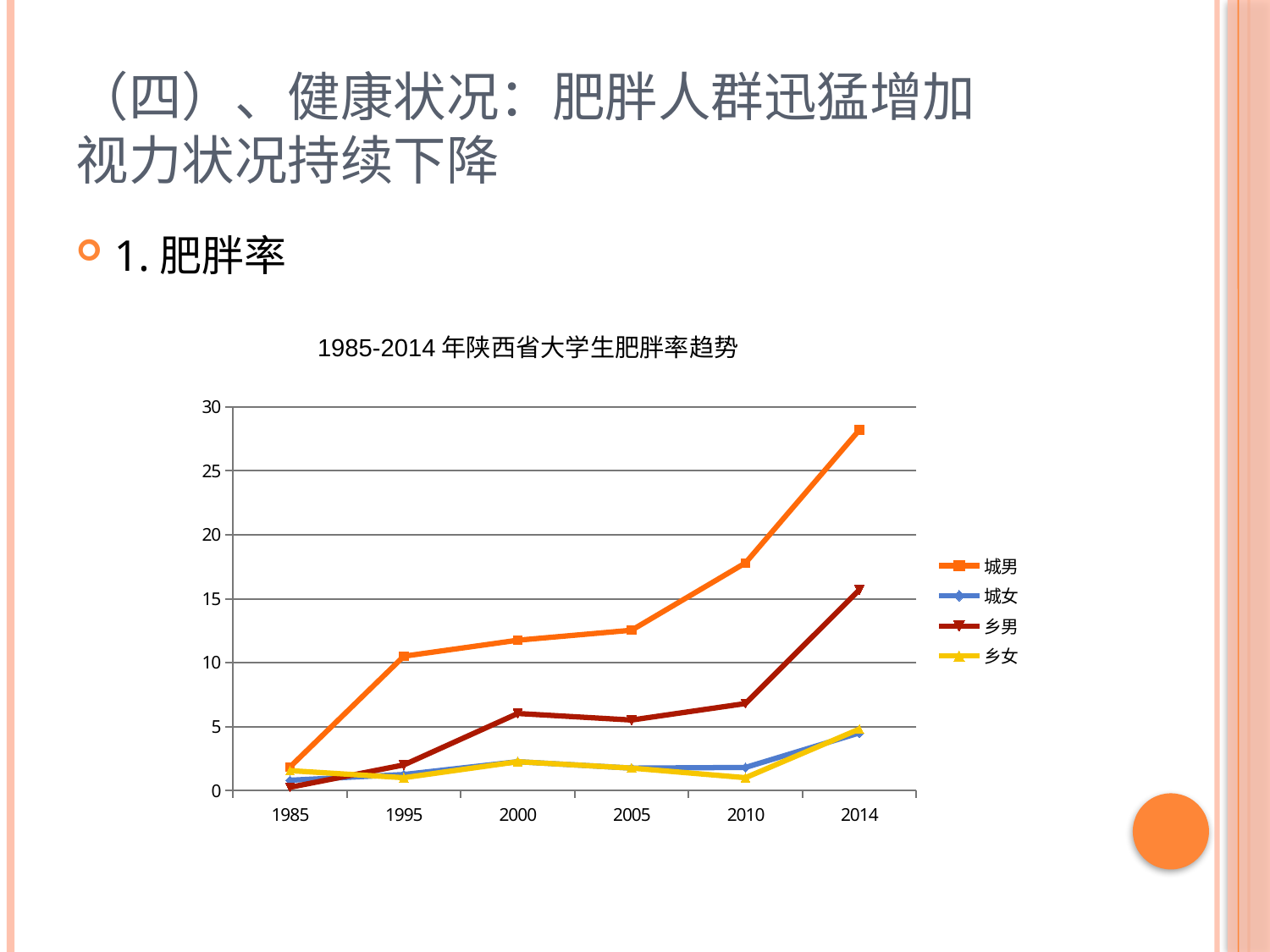
What kind of chart is shown on the slide? line chart Which series has the highest value in 2014? 城男 Which is larger in 2000, the value for 乡男 or the value for 城女? 乡男 How many years are plotted along the x axis? 6 Is the value for 城男 in 2014 greater or less than 25? greater Which is larger in 2010, the value for 城男 or the value for 乡男? 城男 How many series does the legend list? 4 Does the 城男 line rise or fall from 1985 to 2014? rises Is the value for 城男 in 1995 greater or less than 5? greater Is the value for 乡男 in 2005 greater or less than 10? less What is the title of the chart? 1985-2014 年陕西省大学生肥胖率趋势